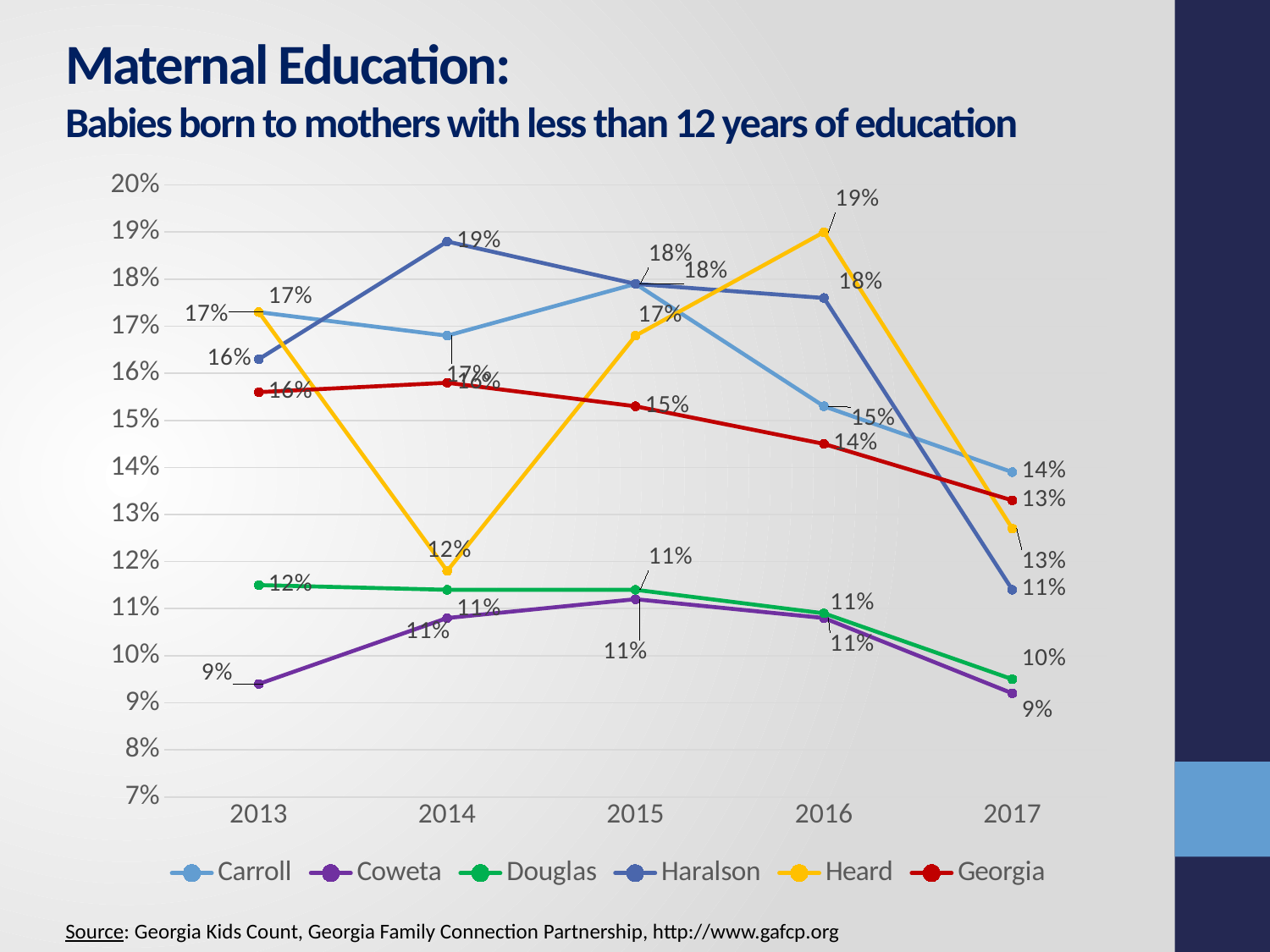
What is the value for Heard in 2016? 19% What is the value for Coweta in 2013? 9% In 2014, which is larger: the value for Haralson or the value for Heard? Haralson How many series does the legend list? 6 How many years are shown on the x axis? 5 What is the value for Georgia in 2017? 13% Which county or series has the lowest value in 2013? Coweta Is the value for Coweta in 2013 greater or less than 10%? less By how many percentage points did Heard's value rise from 2014 to 2016? 7 percentage points Which county or series has the highest value in 2016? Heard Does the Georgia line rise or fall from 2014 to 2017? fall What is the value for Haralson in 2017? 11%